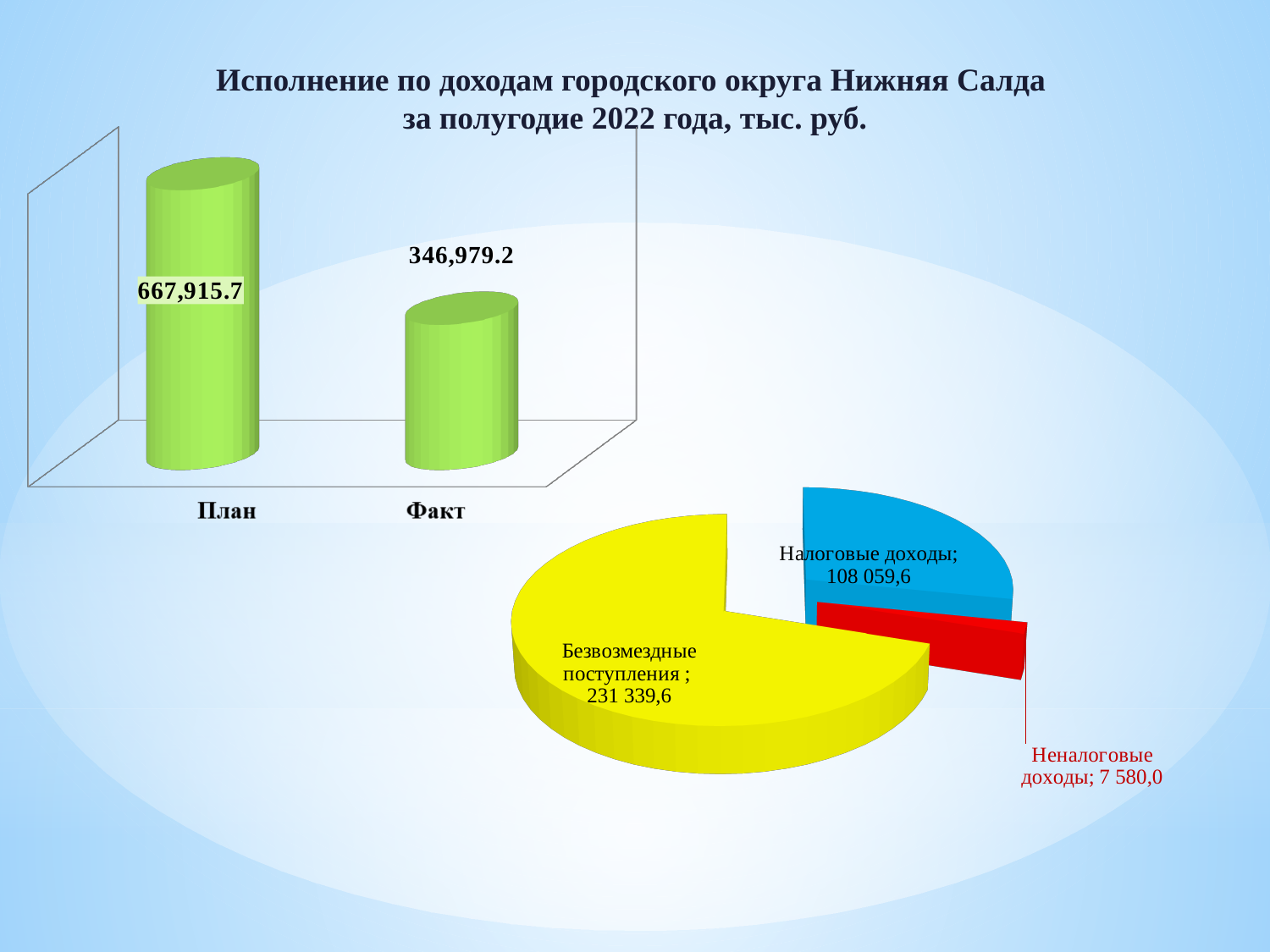
In the pie chart on the right, what colour is the Неналоговые доходы slice? Red What kind of chart is the one on the left showing План and Факт? Bar chart In the bar chart on the left, how many categories are shown? 2 In the bar chart on the left, what is the difference between the План and Факт values? 320,936.5 In the pie chart on the right, which slice is the largest? Безвозмездные поступления In the bar chart on the left, which category has the higher value, План or Факт? План In the pie chart on the right, what is the value for Безвозмездные поступления? 231 339,6 In the pie chart on the right, which slice is the smallest? Неналоговые доходы In the bar chart on the left, what is the value for Факт? 346,979.2 In the pie chart on the right, what is the value for Налоговые доходы? 108 059,6 In the pie chart on the right, what is the value for Неналоговые доходы? 7 580,0 In the bar chart on the left, what is the value for План? 667,915.7